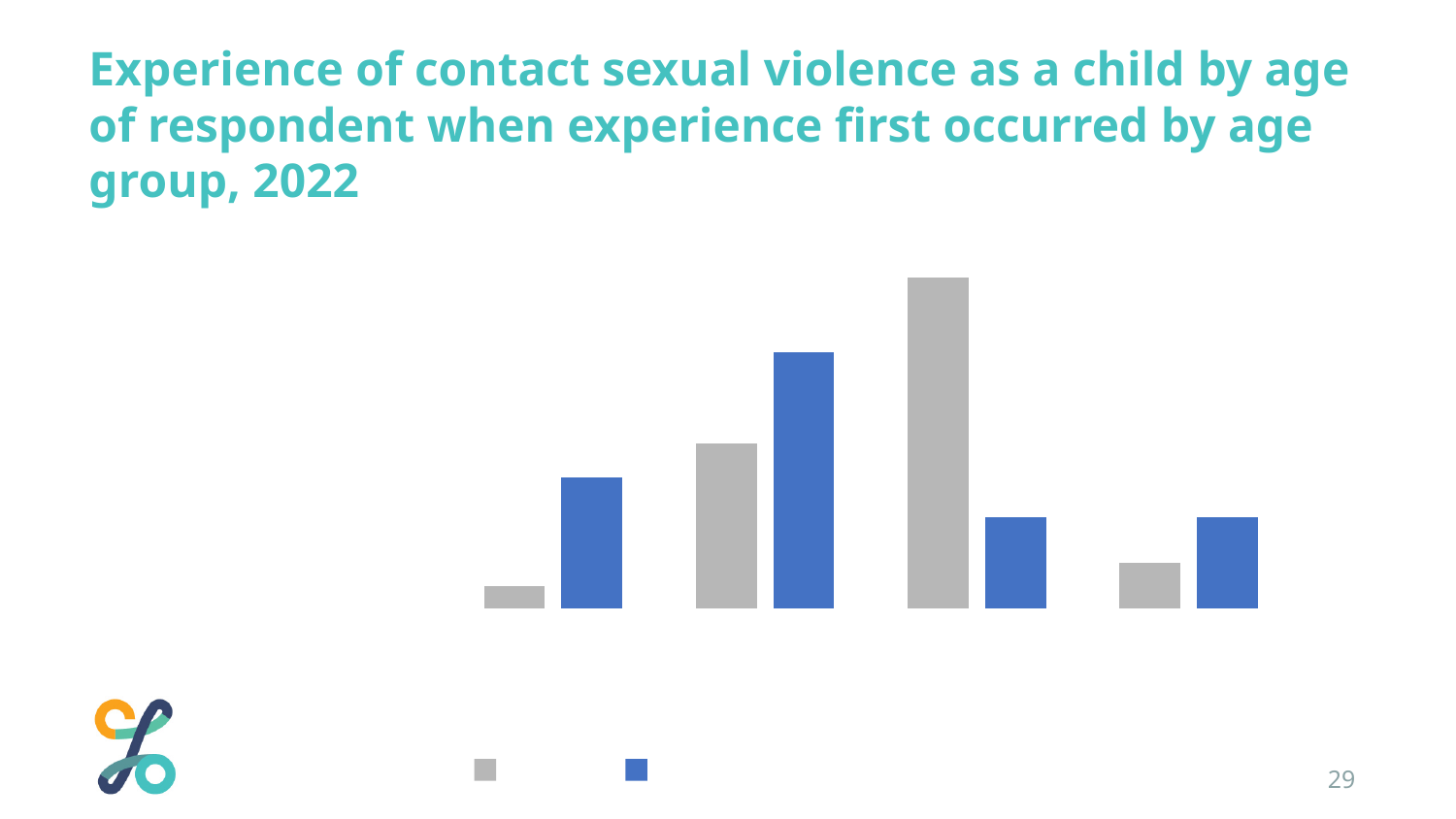
What kind of chart is shown on the slide? bar chart Which group of bars from the left contains the tallest bar in the chart? the third group What two colours are used for the bars in the chart? grey and blue Which group of bars from the left contains the shortest bar in the chart? the first group Is the tallest bar in the chart grey or blue? grey In the fourth group of bars from the left, which bar is taller, the grey one or the blue one? the blue one In the third group of bars from the left, which bar is taller, the grey one or the blue one? the grey one How many groups of bars are plotted in the chart? 4 How many series does the legend show? 2 What is the title of the chart on the slide? Experience of contact sexual violence as a child by age of respondent when experience first occurred by age group, 2022 In the first (leftmost) group of bars, which bar is taller, the grey one or the blue one? the blue one How many bars are plotted in total in the chart? 8